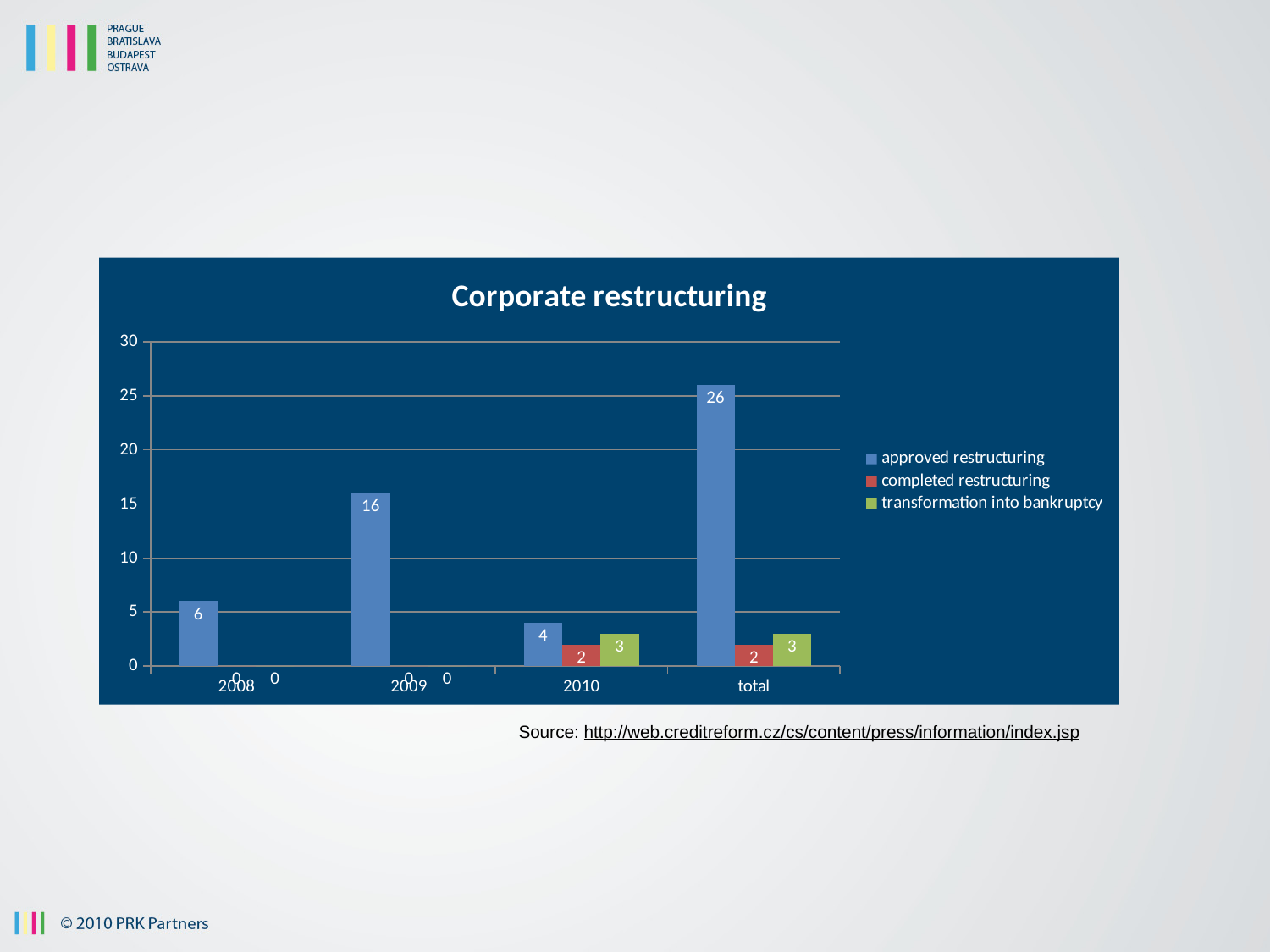
What is the value for approved restructuring in 2009? 16 What is the title of the chart? Corporate restructuring Which is larger in 2010: completed restructuring or transformation into bankruptcy? transformation into bankruptcy Which year has the lowest value for approved restructuring? 2010 What is the value for completed restructuring in 2010? 2 What is the difference between approved restructuring in 2009 and in 2008? 10 How many series does the legend list? 3 What is the value for transformation into bankruptcy in 2010? 3 What is the value for approved restructuring in the total category? 26 Which category has the highest value for approved restructuring? total What kind of chart is shown? bar chart How many categories are shown on the x axis? 4